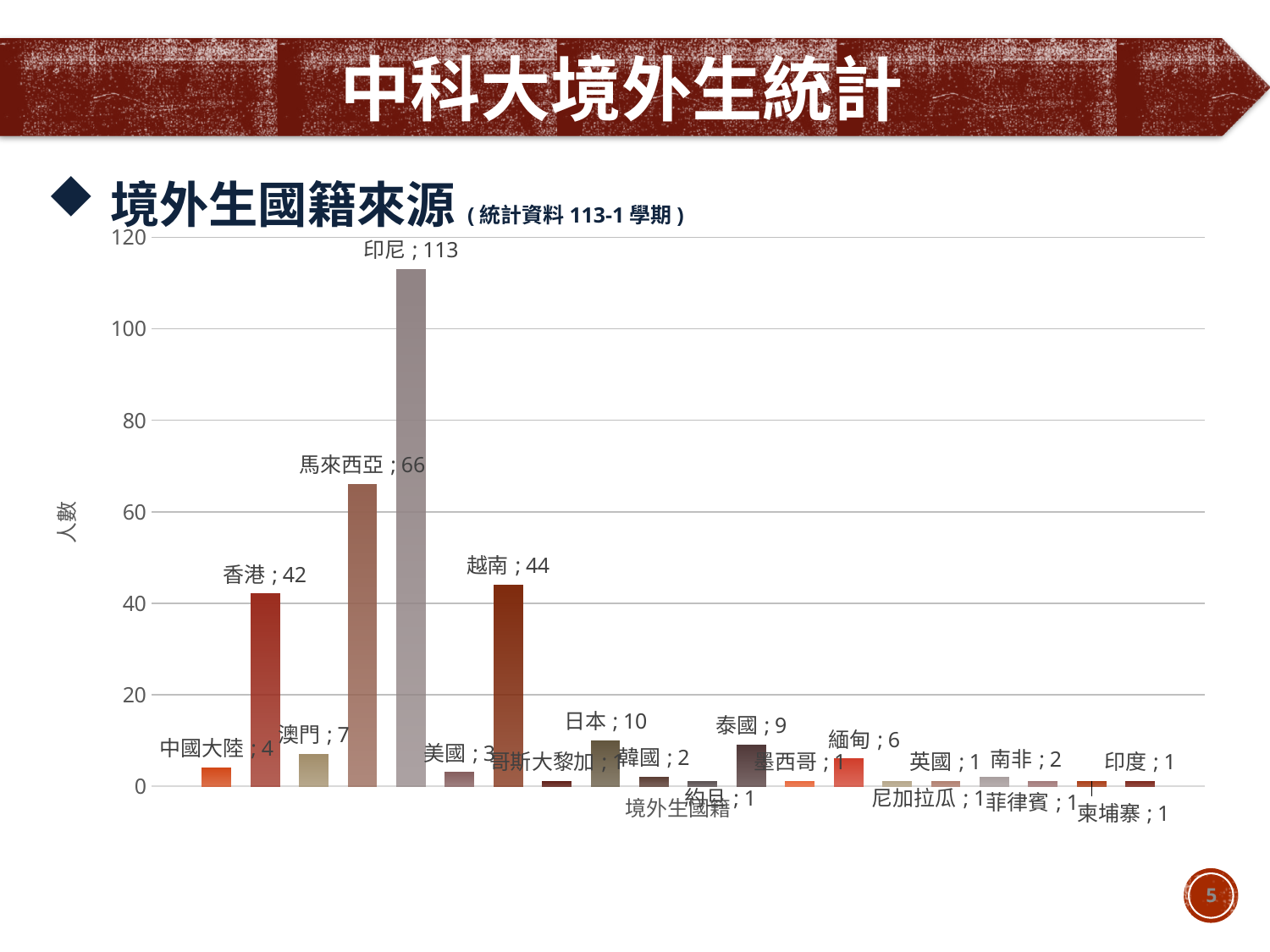
What is the number of students from 印尼 (Indonesia)? 113 What is the number of students from 越南 (Vietnam)? 44 Which country has the highest number of students? 印尼 What is the difference between the number of students from 越南 and from 香港? 2 What is the label of the y axis? 人數 Is the value for 香港 greater or less than 40? greater Which has more students, 泰國 or 緬甸? 泰國 How many countries/regions are shown on the x axis? 20 What is the number of students from 馬來西亞 (Malaysia)? 66 What is the number of students from 日本 (Japan)? 10 What type of chart is shown on the slide? bar chart What is the difference between the number of students from 印尼 and from 馬來西亞? 47